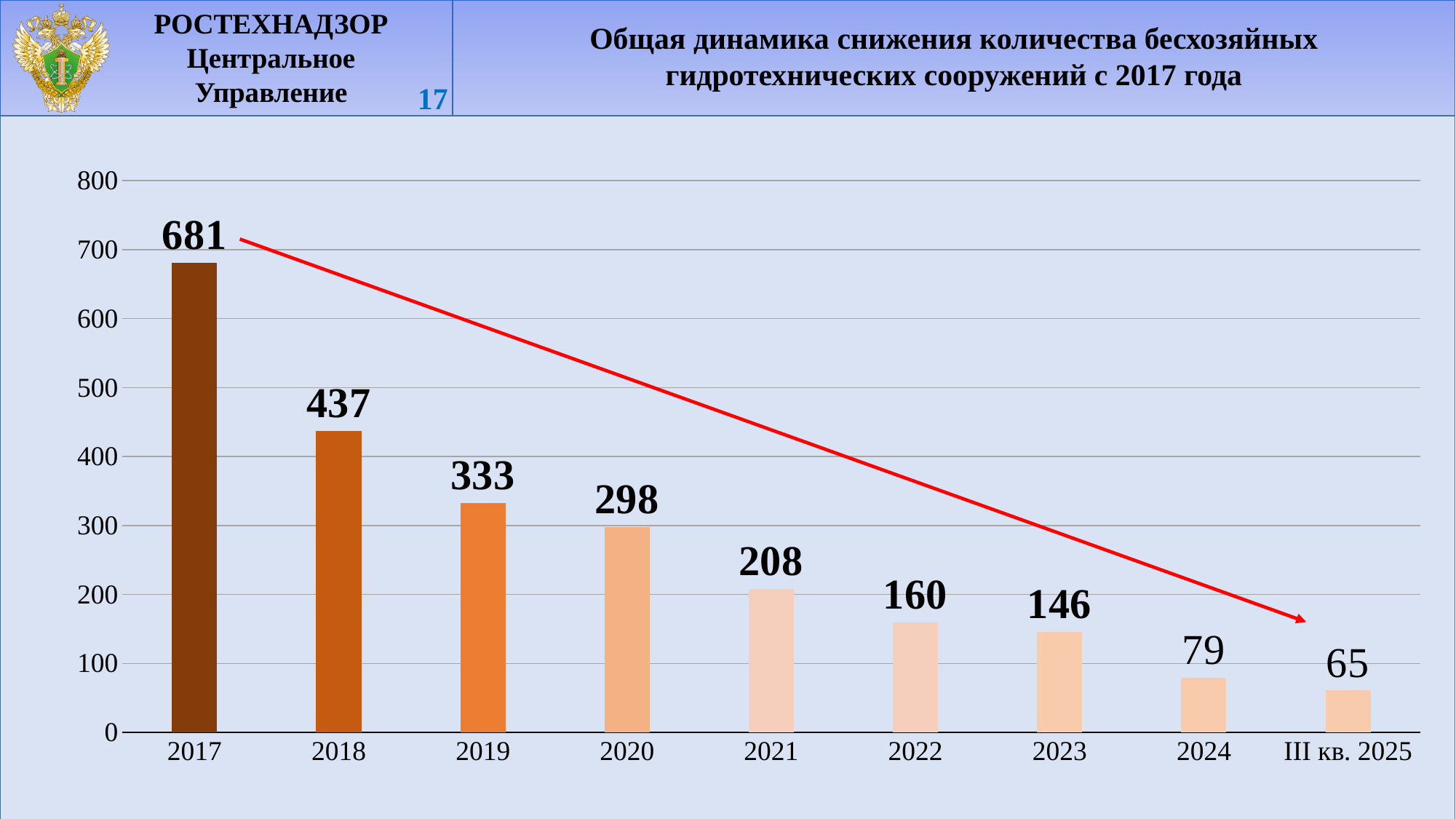
Do the values rise or fall from 2017 to III кв. 2025? fall What is the difference between the values for 2023 and 2024? 67 Which category has the highest value? 2017 What is the difference between the values for 2017 and 2018? 244 What is the value for 2021? 208 What is the value for 2017? 681 How many categories are shown on the x axis? 9 Which category has the lowest value? III кв. 2025 Is the value for 2022 greater or less than 200? less Which is larger, the value for 2019 or the value for 2020? 2019 What kind of chart is shown on the slide? bar chart What is the value for III кв. 2025? 65